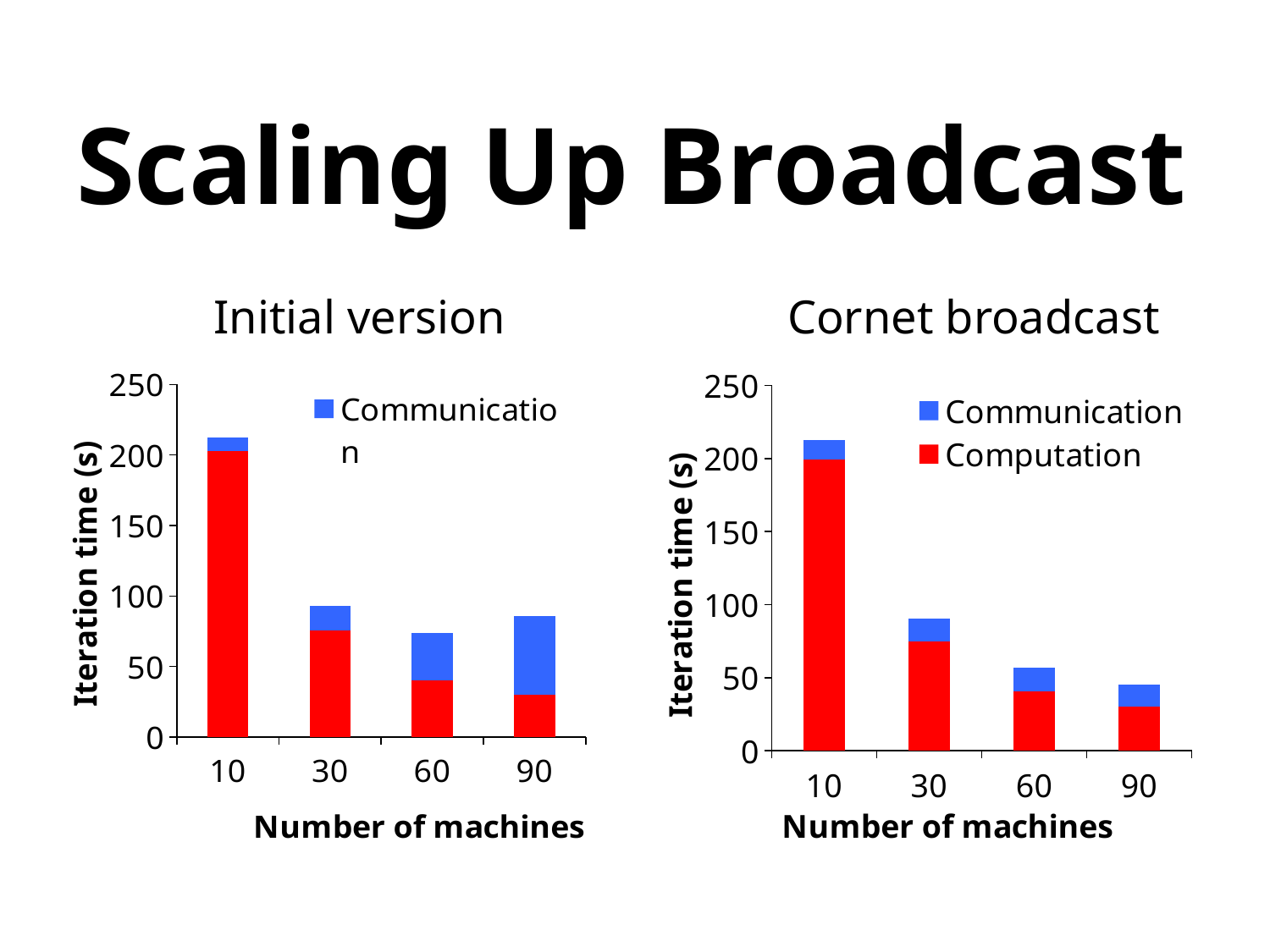
What is the y-axis label of the "Cornet broadcast" chart? Iteration time (s) In the "Initial version" chart, which number of machines has the highest total iteration time? 10 In the "Initial version" chart, which has the larger total iteration time: 60 machines or 90 machines? 90 machines What kind of chart is the "Initial version" chart? bar chart In the "Initial version" chart, is the total iteration time for 10 machines greater or less than 200? greater In the "Initial version" chart, is the total iteration time for 90 machines greater or less than 100? less In the "Cornet broadcast" chart, is the total iteration time for 90 machines greater or less than 50? less In the "Cornet broadcast" chart, does the total iteration time rise or fall as the number of machines increases? fall How many categories (numbers of machines) are shown on the x axis of the "Cornet broadcast" chart? 4 How many series does the legend of the "Cornet broadcast" chart list? 2 In the "Cornet broadcast" chart, which number of machines has the highest total iteration time? 10 In the "Cornet broadcast" chart, which number of machines has the lowest total iteration time? 90